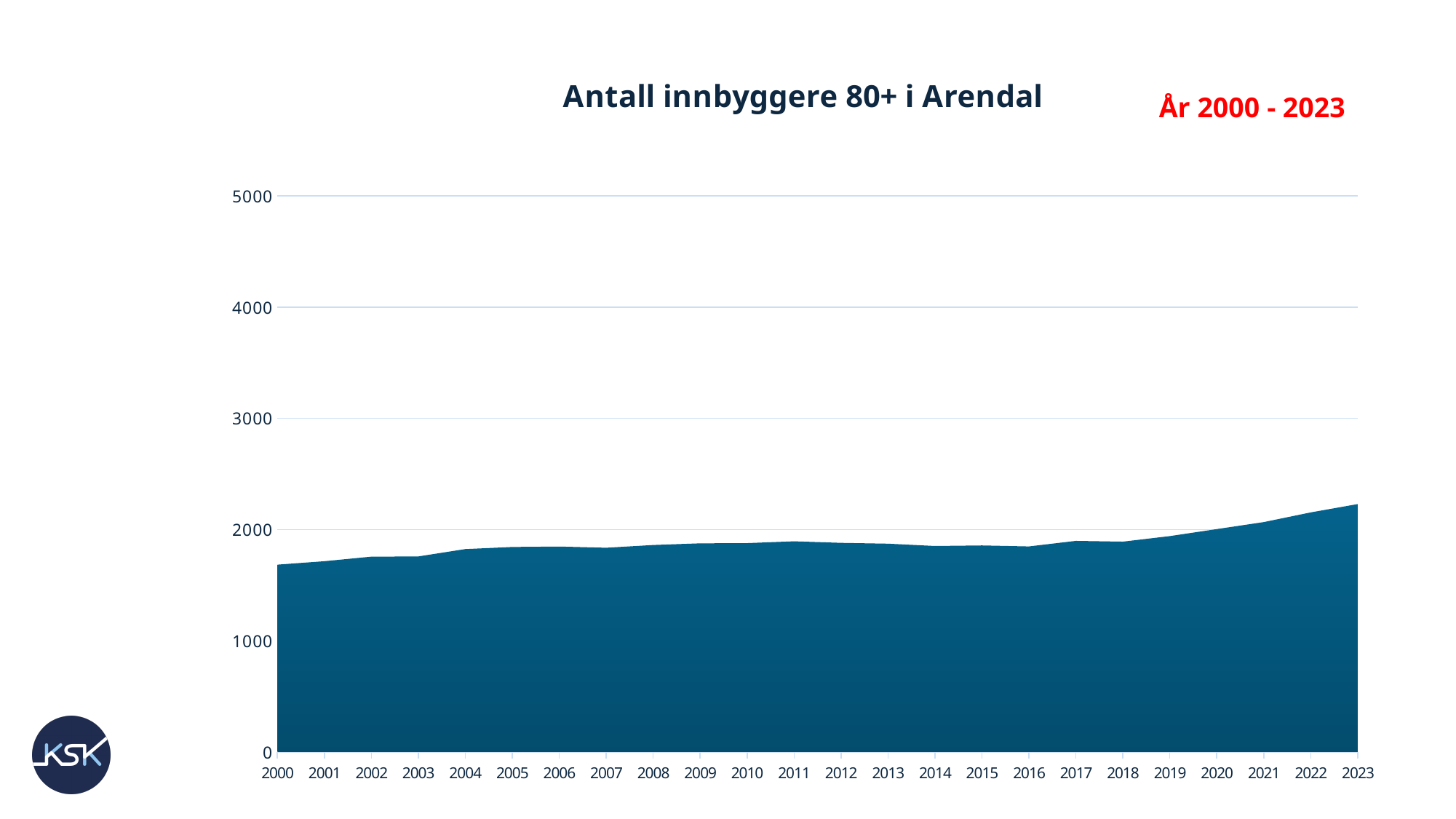
Is the value for 2023 greater or less than 2000? greater Which year has the lowest value? 2000 Which year has the highest value? 2023 What year range is shown in red text on the slide? År 2000 - 2023 What is the title of the chart? Antall innbyggere 80+ i Arendal Is the value for 2005 greater or less than 1000? greater Is the value for 2000 greater or less than 2000? less Which is larger, the value for 2023 or the value for 2000? 2023 Do the values generally rise or fall from 2000 to 2023? rise What kind of chart is shown on the slide? area chart How many years are plotted along the x axis? 24